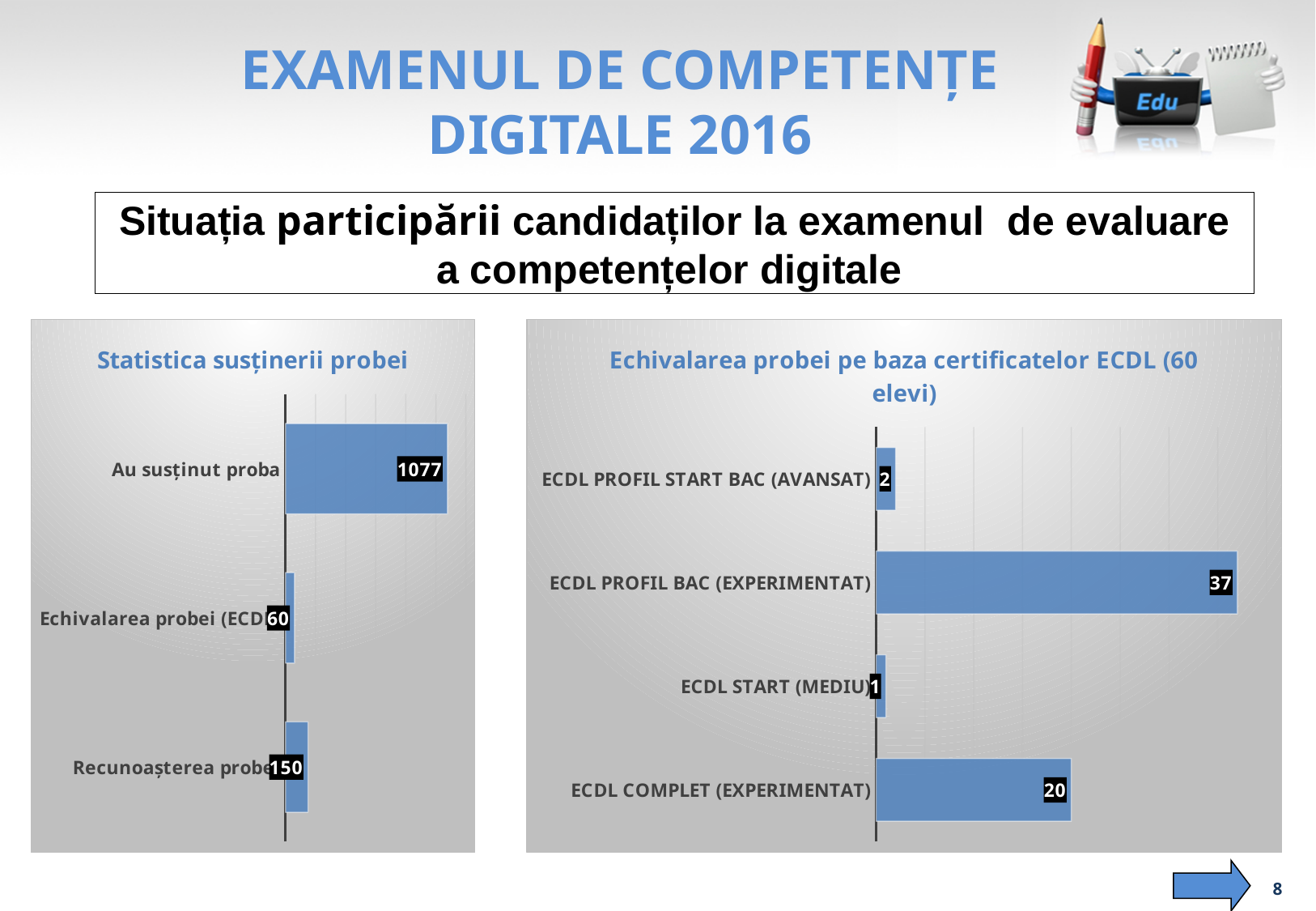
In the chart titled "Echivalarea probei pe baza certificatelor ECDL (60 elevi)", what is the value for "ECDL COMPLET (EXPERIMENTAT)"? 20 In the chart titled "Statistica susținerii probei", what is the value for "Au susținut proba"? 1077 In the chart titled "Statistica susținerii probei", what is the value for "Recunoașterea probei"? 150 In the chart titled "Statistica susținerii probei", which category has the lowest value? Echivalarea probei (ECDL) What type of chart is the chart on the right of the slide? Bar chart In the chart titled "Echivalarea probei pe baza certificatelor ECDL (60 elevi)", which is larger: "ECDL PROFIL START BAC (AVANSAT)" or "ECDL START (MEDIU)"? ECDL PROFIL START BAC (AVANSAT) In the chart titled "Echivalarea probei pe baza certificatelor ECDL (60 elevi)", what is the value for "ECDL PROFIL BAC (EXPERIMENTAT)"? 37 In the chart titled "Statistica susținerii probei", how many categories are shown? 3 In the chart titled "Statistica susținerii probei", what is the difference between "Au susținut proba" and "Recunoașterea probei"? 927 In the chart titled "Echivalarea probei pe baza certificatelor ECDL (60 elevi)", which category has the highest value? ECDL PROFIL BAC (EXPERIMENTAT) In the chart titled "Echivalarea probei pe baza certificatelor ECDL (60 elevi)", what is the difference between "ECDL PROFIL BAC (EXPERIMENTAT)" and "ECDL COMPLET (EXPERIMENTAT)"? 17 In the chart titled "Echivalarea probei pe baza certificatelor ECDL (60 elevi)", which category has the lowest value? ECDL START (MEDIU)